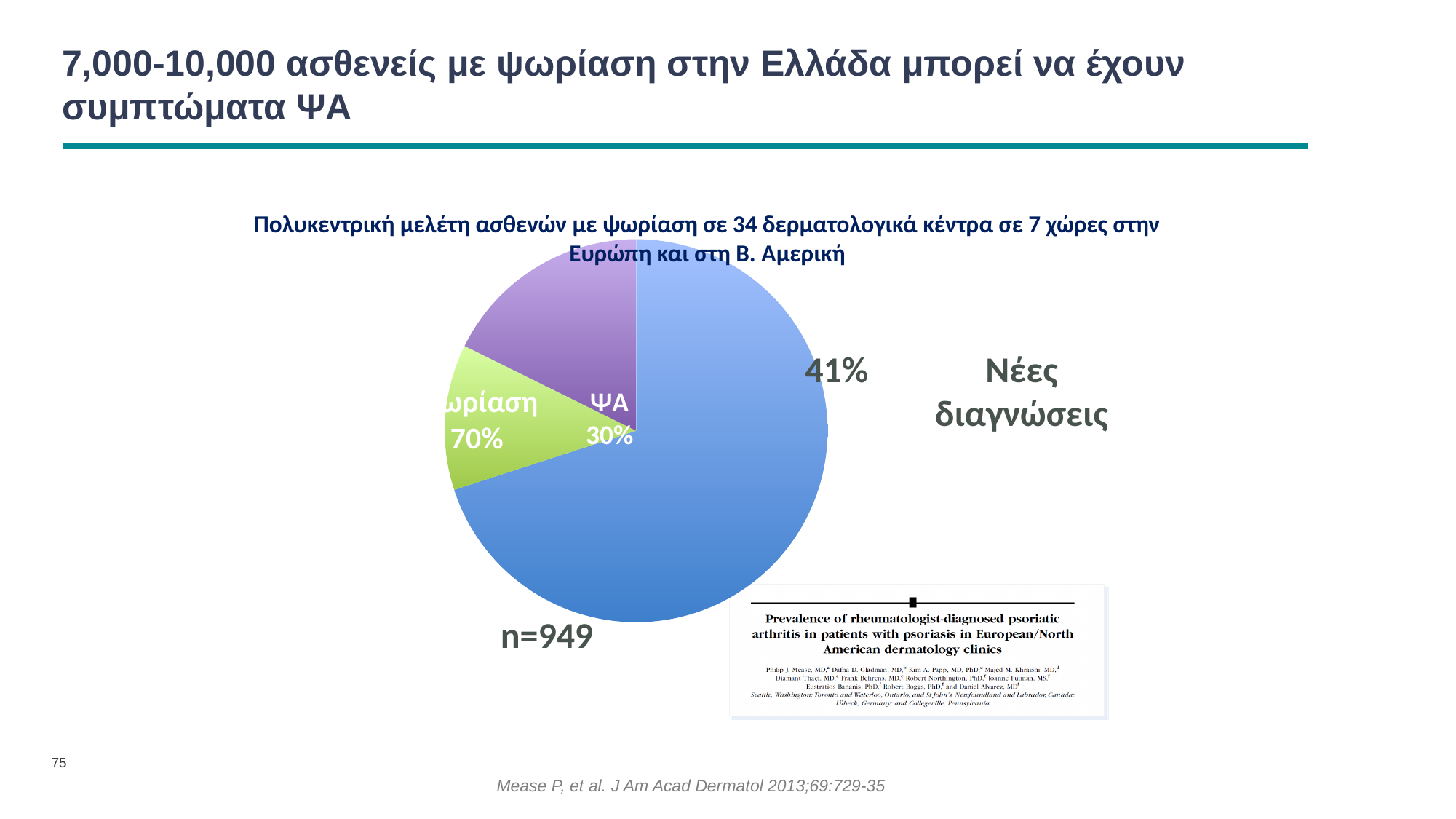
What colour is the largest slice of the pie chart? Blue What percentage is shown for Ψωρίαση in the pie chart? 70% Is the share shown for Ψωρίαση greater or less than 50%? greater Which labelled category has the larger share of the pie, Ψωρίαση or ΨΑ? Ψωρίαση What is the difference in percentage points between the Ψωρίαση share (70%) and the ΨΑ share (30%)? 40 percentage points What percentage is printed next to the label Νέες διαγνώσεις? 41% Which labelled category has the largest share of the pie chart? Ψωρίαση What percentage is shown for ΨΑ in the pie chart? 30% How many slices does the pie chart have? 3 What sample size (n) is printed below the pie chart? n=949 What kind of chart is shown on the slide? Pie chart